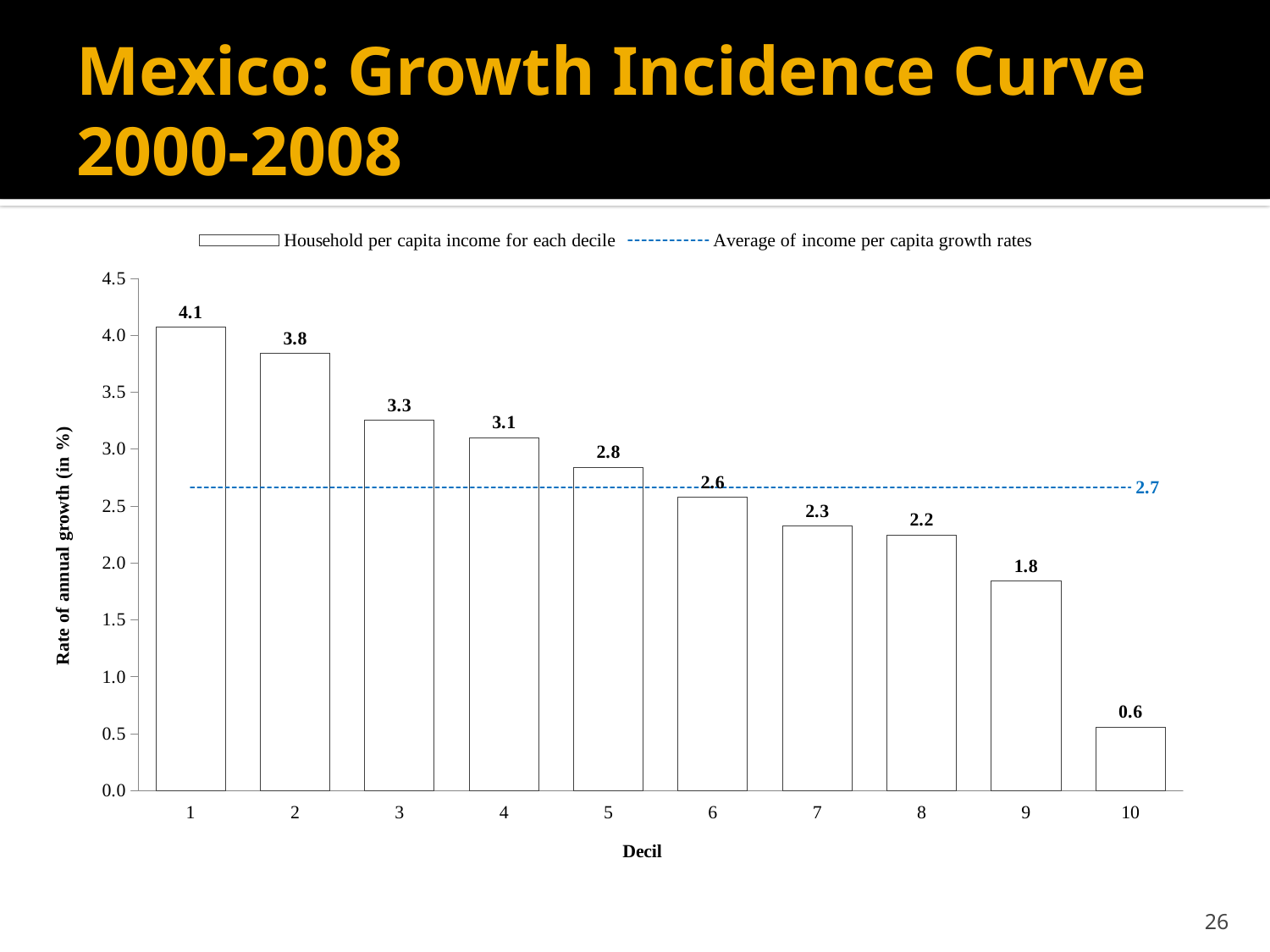
What value is labelled on the dashed line for the average of income per capita growth rates? 2.7 What is the difference between the growth rates of decile 1 and decile 10? 3.5 What kind of chart is shown on the slide? Combination bar and line chart Which decile has the highest rate of annual growth? 1 Do the growth rates rise or fall as the decile number increases? Fall What is the rate of annual growth for decile 5? 2.8 What is the rate of annual growth for decile 10? 0.6 Which has a higher rate of annual growth, decile 3 or decile 7? Decile 3 How many deciles are shown on the x axis? 10 How many entries does the legend list? 2 What is the rate of annual growth for decile 1? 4.1 Which decile has the lowest rate of annual growth? 10